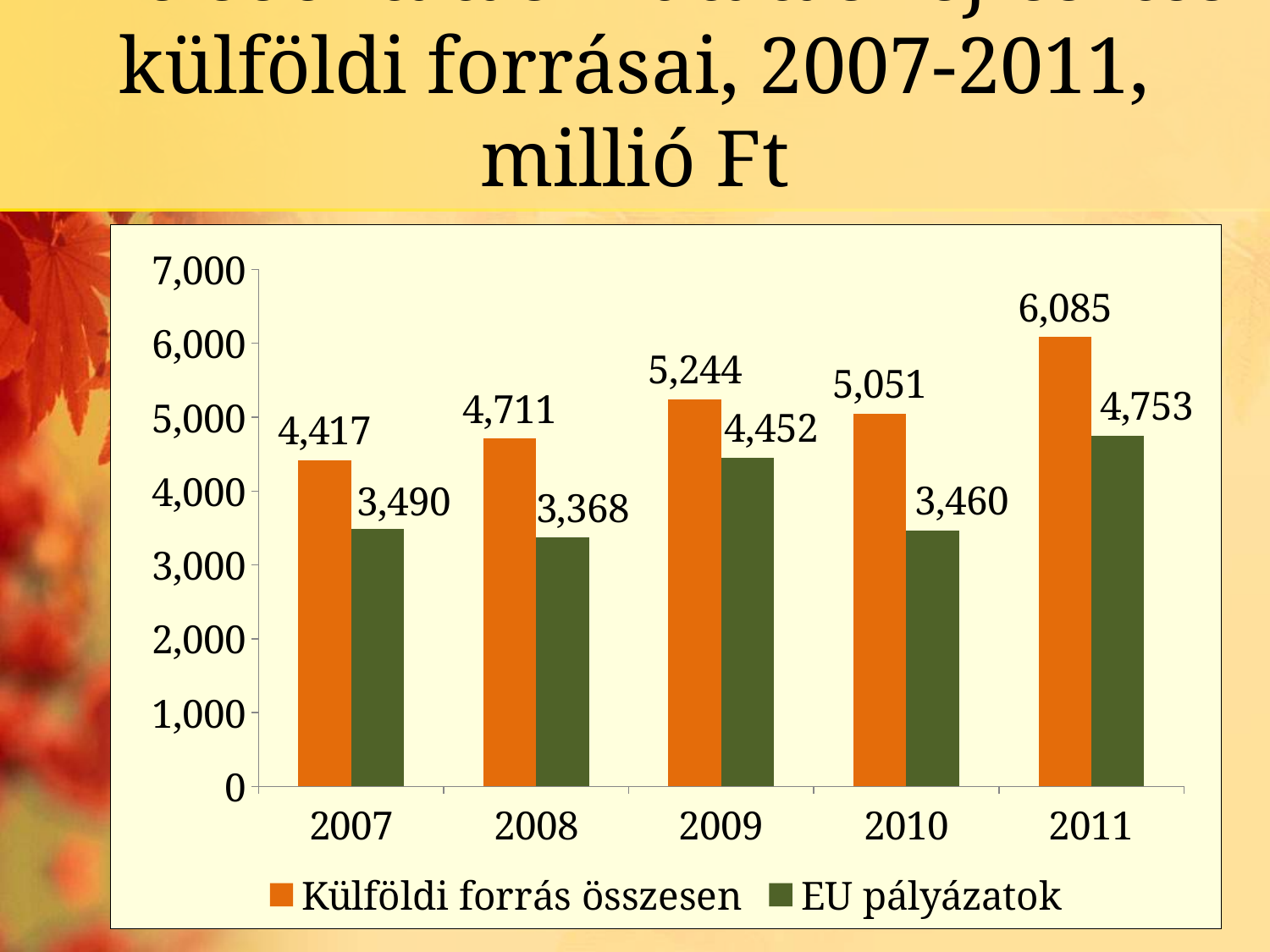
Which is larger: Külföldi forrás összesen in 2009 or in 2010? 2009 How many years are shown on the x axis? 5 In which year is Külföldi forrás összesen highest? 2011 How many series does the legend list? 2 What is the value for Külföldi forrás összesen in 2007? 4,417 What is the value for EU pályázatok in 2008? 3,368 What is the value for Külföldi forrás összesen in 2011? 6,085 Which colour represents EU pályázatok in the chart? green What is the value for EU pályázatok in 2009? 4,452 In which year is EU pályázatok lowest? 2008 What kind of chart is shown on the slide? bar chart What is the difference between Külföldi forrás összesen and EU pályázatok in 2010? 1,591